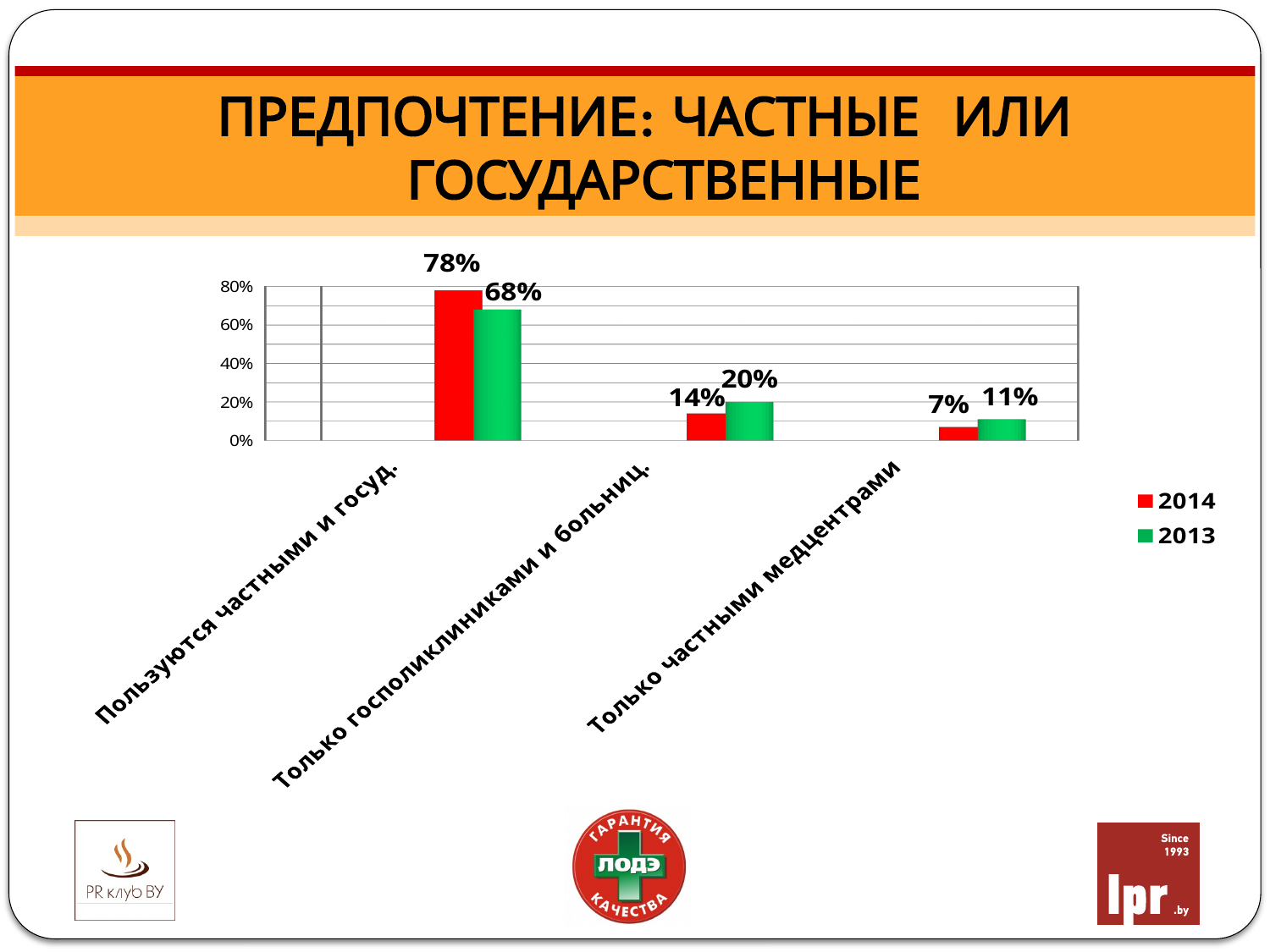
What is the difference between the 2013 and 2014 values for "Только частными медцентрами"? 4% Which colour represents the 2013 series? green Which category has the highest 2013 value? Пользуются частными и госуд. How many series does the legend list? 2 What is the 2014 value for "Пользуются частными и госуд."? 78% Which category has the lowest 2014 value? Только частными медцентрами What is the difference between the 2014 and 2013 values for "Пользуются частными и госуд."? 10% What kind of chart is shown on the slide? bar chart Which is larger for "Только госполиклиниками и больниц.": the 2014 value or the 2013 value? 2013 How many categories are shown on the x axis? 3 What is the 2014 value for "Только частными медцентрами"? 7% What is the 2013 value for "Только госполиклиниками и больниц."? 20%